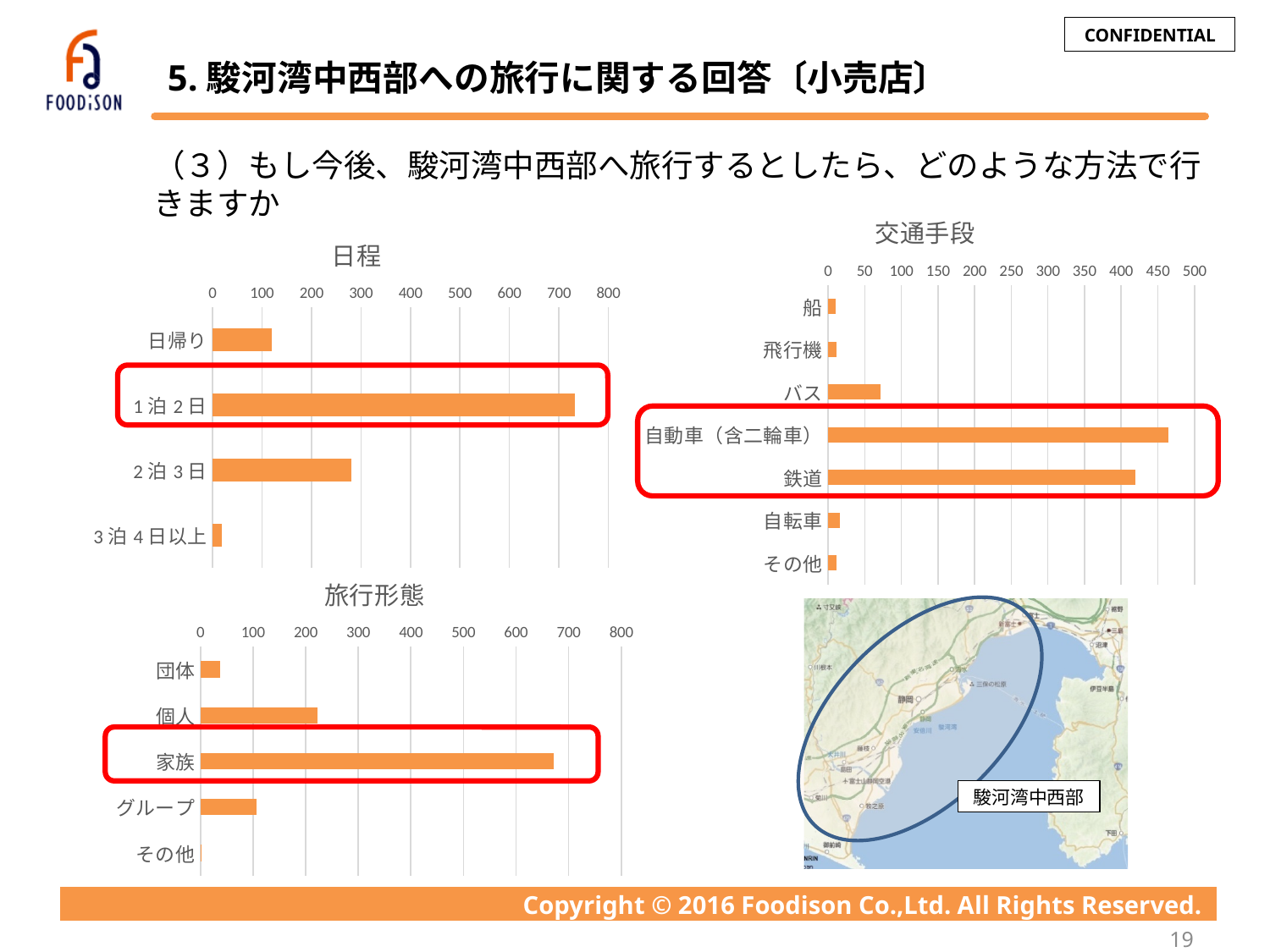
How many categories are shown in the 日程 chart? 4 In the 日程 chart, is the value for 1泊2日 greater or less than 700? greater In the 日程 chart, which category has the highest value? 1泊2日 In the 日程 chart, which category has the lowest value? 3泊4日以上 In the 交通手段 chart, which category has the highest value? 自動車（含二輪車） In the 交通手段 chart, is the value for バス greater or less than 100? less In the 日程 chart, is the value for 2泊3日 greater or less than 300? less In the 交通手段 chart, which is larger, 自動車（含二輪車） or 鉄道? 自動車（含二輪車） In the 旅行形態 chart, which category has the highest value? 家族 What type of chart is the 旅行形態 chart? bar chart How many categories are shown in the 交通手段 chart? 7